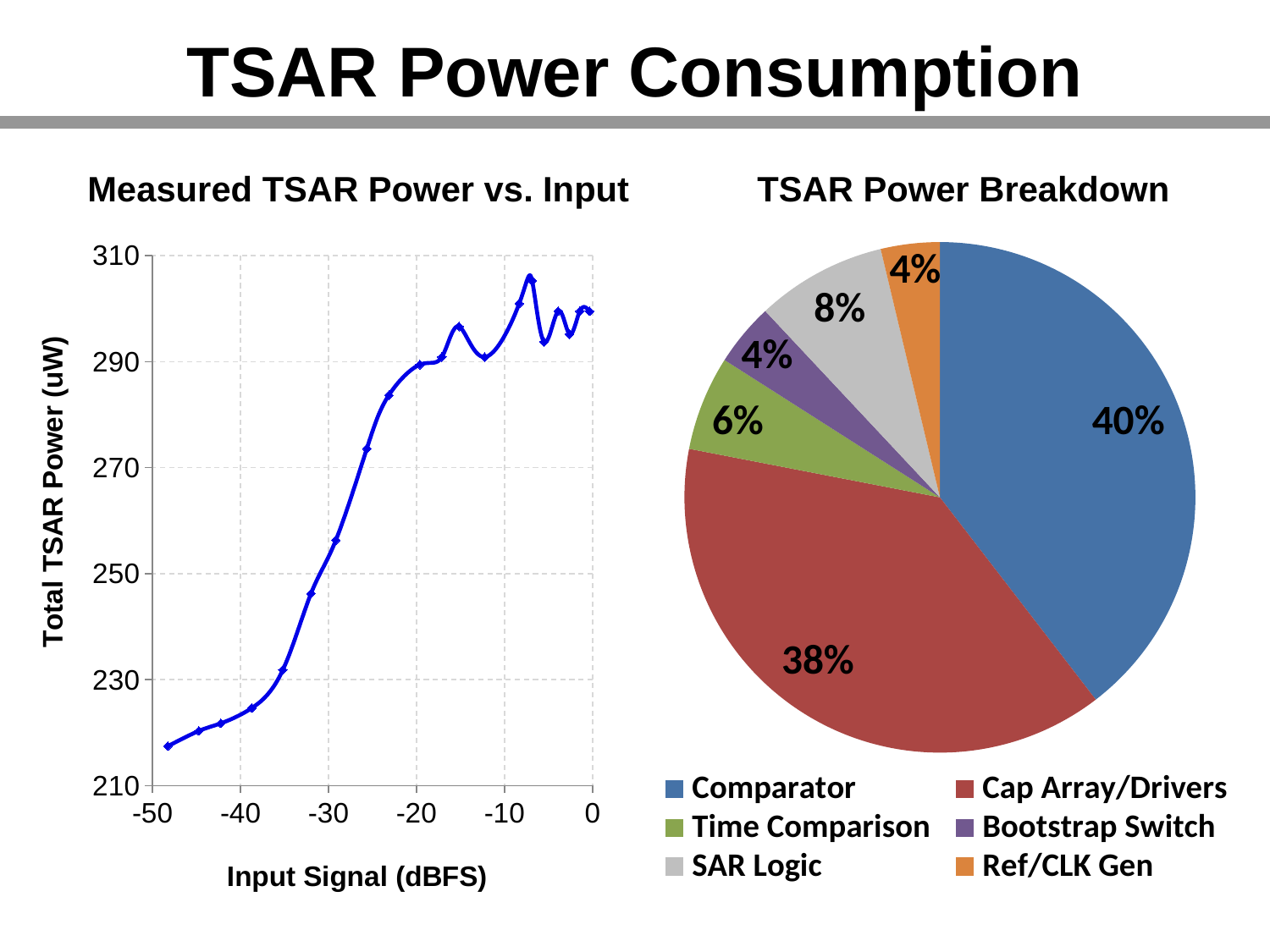
In the TSAR Power Breakdown pie chart, what share of power does the Comparator account for? 40% In the TSAR Power Breakdown pie chart, which component has the largest share? Comparator In the Measured TSAR Power vs. Input chart, is the total TSAR power at -48 dBFS greater or less than 230 uW? less What kind of chart is the Measured TSAR Power vs. Input chart? Line chart In the TSAR Power Breakdown pie chart, which is larger, the share for Time Comparison or the share for SAR Logic? SAR Logic In the TSAR Power Breakdown pie chart, what share of power does SAR Logic account for? 8% In the TSAR Power Breakdown pie chart, what share of power does Cap Array/Drivers account for? 38% In the TSAR Power Breakdown pie chart, what is the difference between the Comparator share and the Cap Array/Drivers share? 2% How many slices does the TSAR Power Breakdown pie chart have? 6 In the Measured TSAR Power vs. Input chart, does the total TSAR power generally rise or fall as the input signal increases from -50 to 0 dBFS? Rise In the Measured TSAR Power vs. Input chart, is the total TSAR power at -10 dBFS greater or less than 290 uW? greater What kind of chart is the TSAR Power Breakdown chart? Pie chart